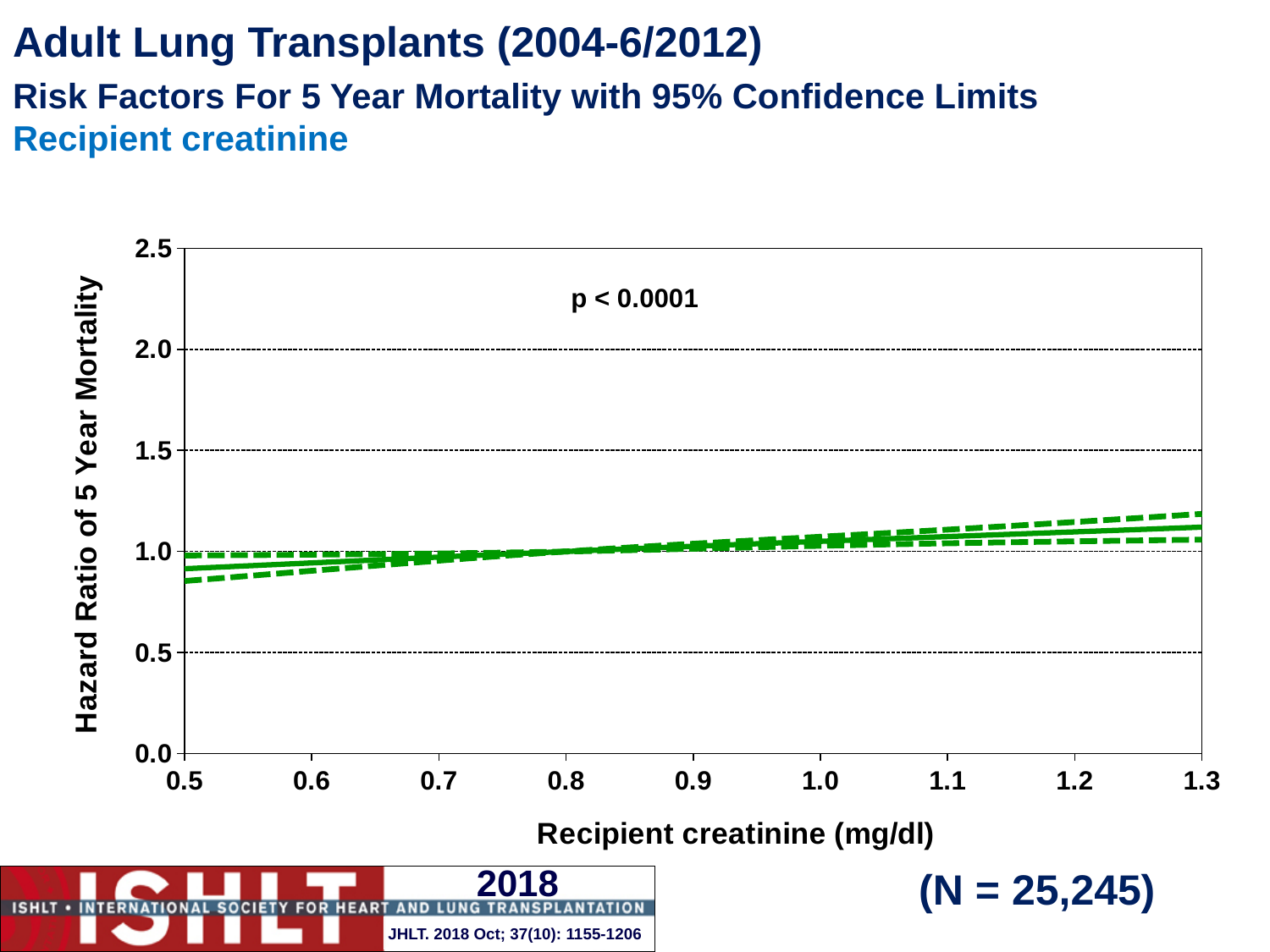
Is the hazard ratio (solid line) at a recipient creatinine of 0.5 mg/dl greater or less than 1.0? less What is the sample size (N) shown on the slide? N = 25,245 Is the hazard ratio (solid line) at a recipient creatinine of 1.3 mg/dl greater or less than 1.0? greater Is the upper 95% confidence limit at a recipient creatinine of 1.3 mg/dl greater or less than 1.5? less What kind of chart is shown on the slide? line chart Does the hazard ratio of 5 year mortality rise or fall as recipient creatinine increases from 0.5 to 1.3 mg/dl? rise How many lines (estimate plus confidence limits) are plotted on the chart? 3 Which is larger: the hazard ratio at a recipient creatinine of 1.3 mg/dl or at 0.5 mg/dl? 1.3 mg/dl What p-value is printed on the chart? p < 0.0001